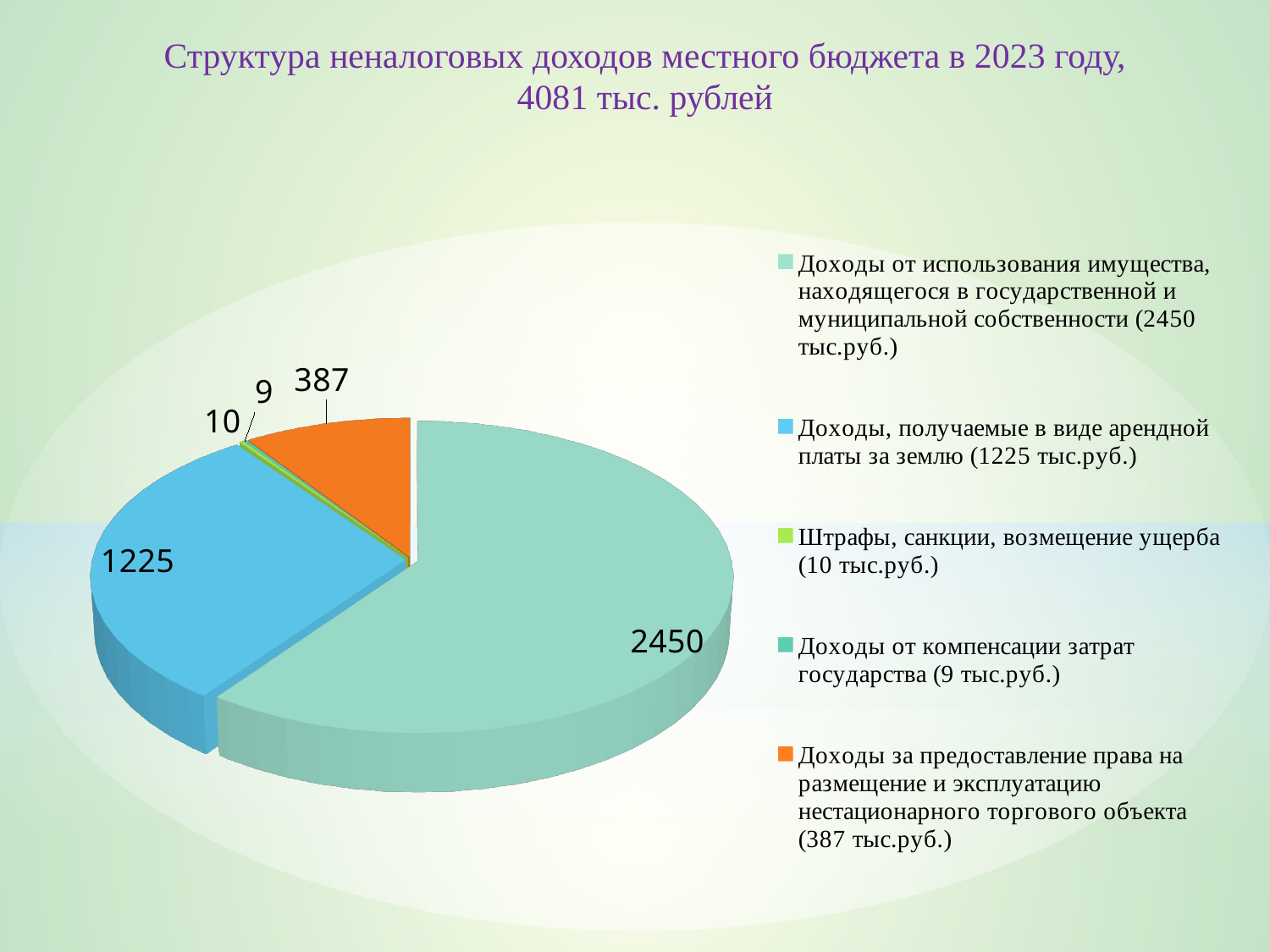
What is the title of the chart on the slide? Структура неналоговых доходов местного бюджета в 2023 году, 4081 тыс. рублей Which category has the largest slice of the pie? Доходы от использования имущества, находящегося в государственной и муниципальной собственности What kind of chart is shown on the slide? pie chart What is the value for Доходы от использования имущества, находящегося в государственной и муниципальной собственности? 2450 Which is larger: the value for Доходы за предоставление права на размещение нестационарного торгового объекта or the value for Доходы, получаемые в виде арендной платы за землю? Доходы, получаемые в виде арендной платы за землю What share of the pie does the slice with value 2450 represent, given the total of 4081? 60% What is the value for Доходы за предоставление права на размещение и эксплуатацию нестационарного торгового объекта? 387 Which category has the smallest value in the pie? Доходы от компенсации затрат государства What is the value for Доходы, получаемые в виде арендной платы за землю? 1225 What is the value for Штрафы, санкции, возмещение ущерба? 10 What is the difference between the value for Доходы от использования имущества (2450) and Доходы, получаемые в виде арендной платы за землю (1225)? 1225 How many categories does the pie chart have? 5